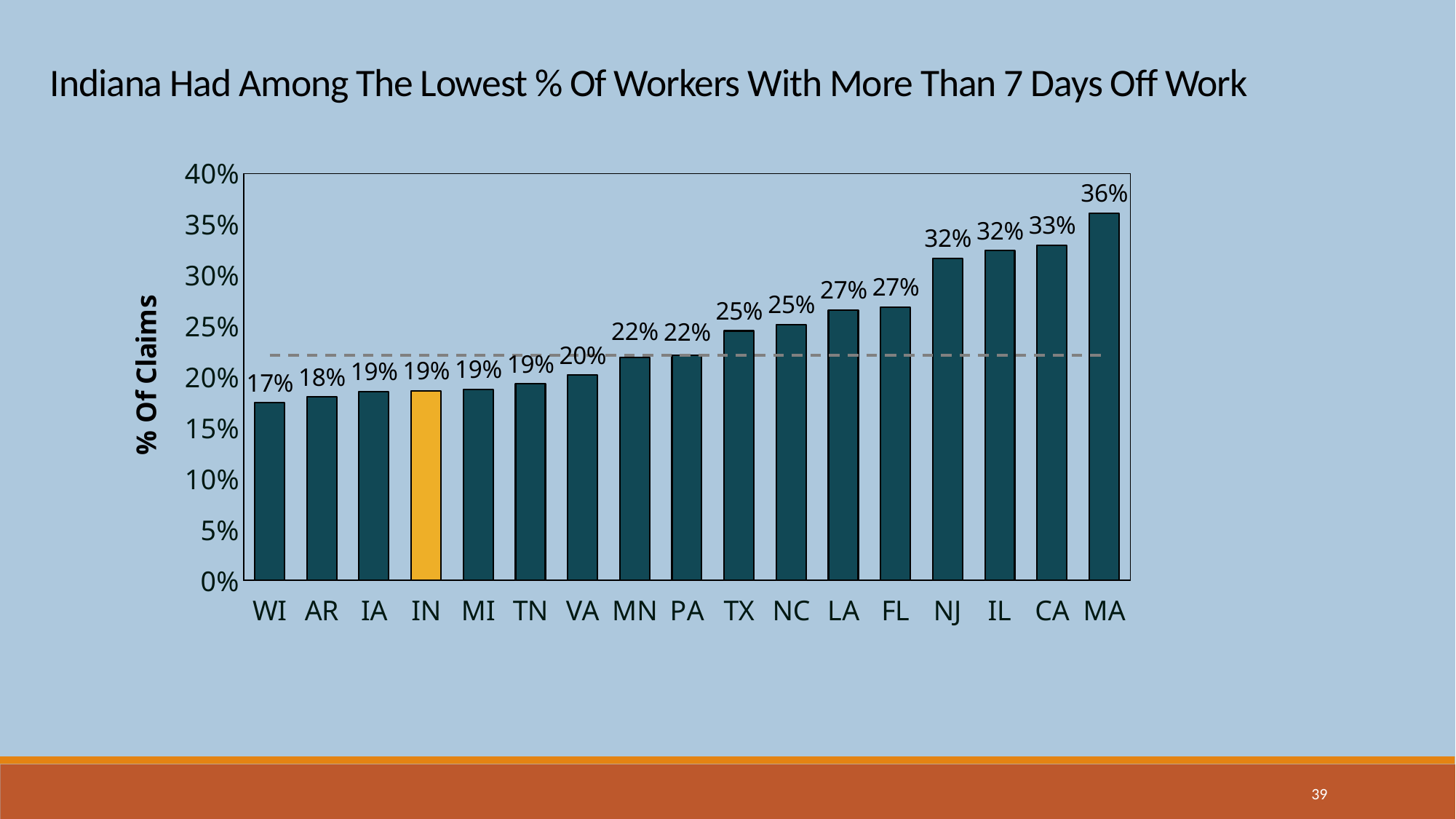
What type of chart is shown on the slide? Bar chart How many states are shown on the x axis? 17 Which state has the lowest % of claims? WI What is the value for IN (Indiana)? 19% Which has a larger value, NJ or VA? NJ What is the value for MA? 36% What is the value for TX? 25% What is the difference between the values for CA and IN? 14% Is the value for LA greater or less than 25%? greater Which state has the highest % of claims? MA What is the difference between the values for MA and WI? 19% Which bar is highlighted in a different colour (orange) from the others? IN